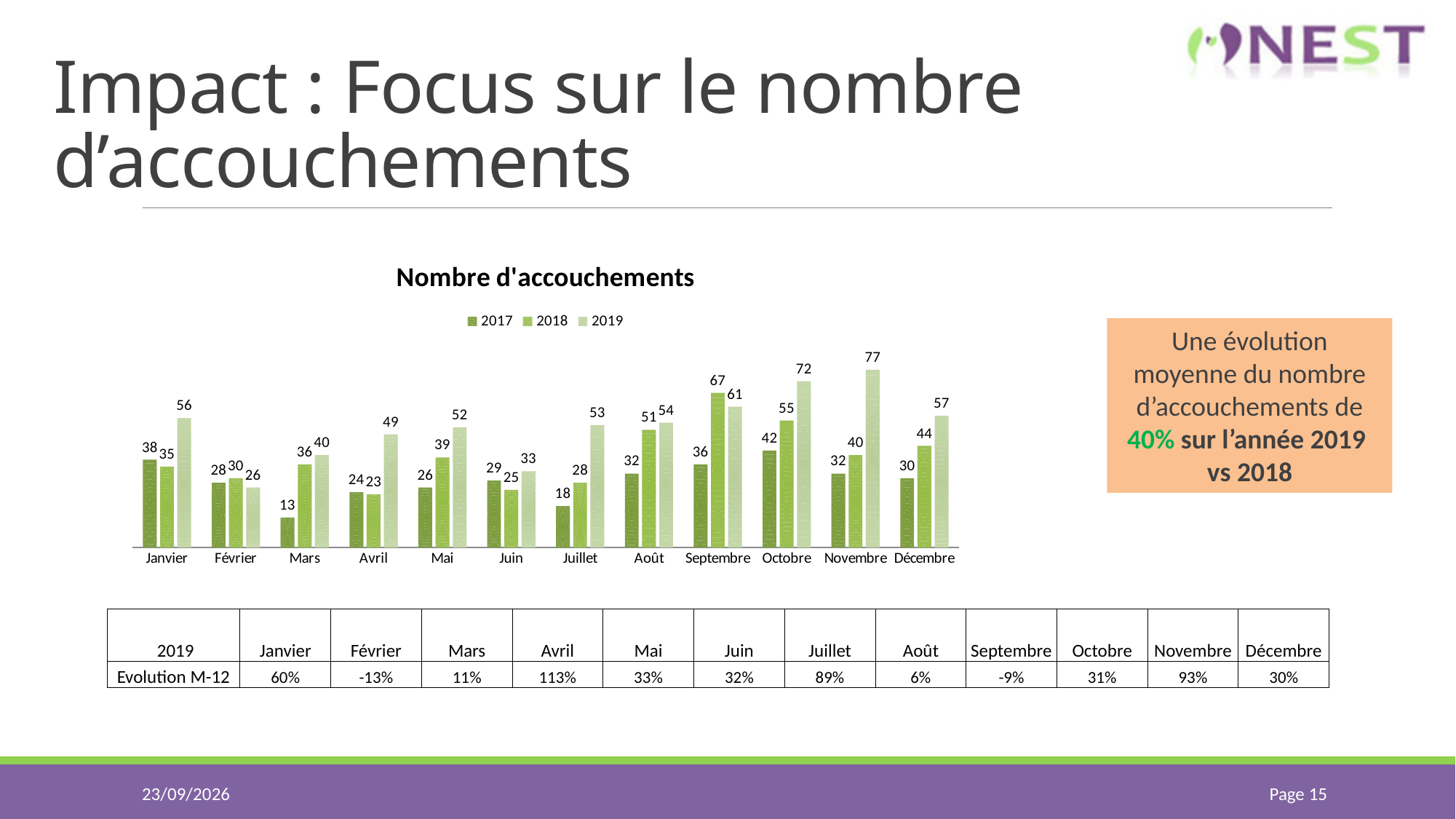
How many series does the chart legend list? 3 What is the difference between the 2019 and 2018 values in Juillet? 25 What is the value for 2019 in Novembre? 77 What type of chart is shown on the slide? bar chart Which month has the lowest value for the 2017 series? Mars What is the title of the chart? Nombre d'accouchements What is the value for 2017 in Mars? 13 How many months (categories) are shown on the x axis of the chart? 12 Which month has the highest value for the 2019 series? Novembre What is the value for 2018 in Septembre? 67 Which month has the highest value for the 2018 series? Septembre In Septembre, which is larger: the 2018 value or the 2019 value? 2018